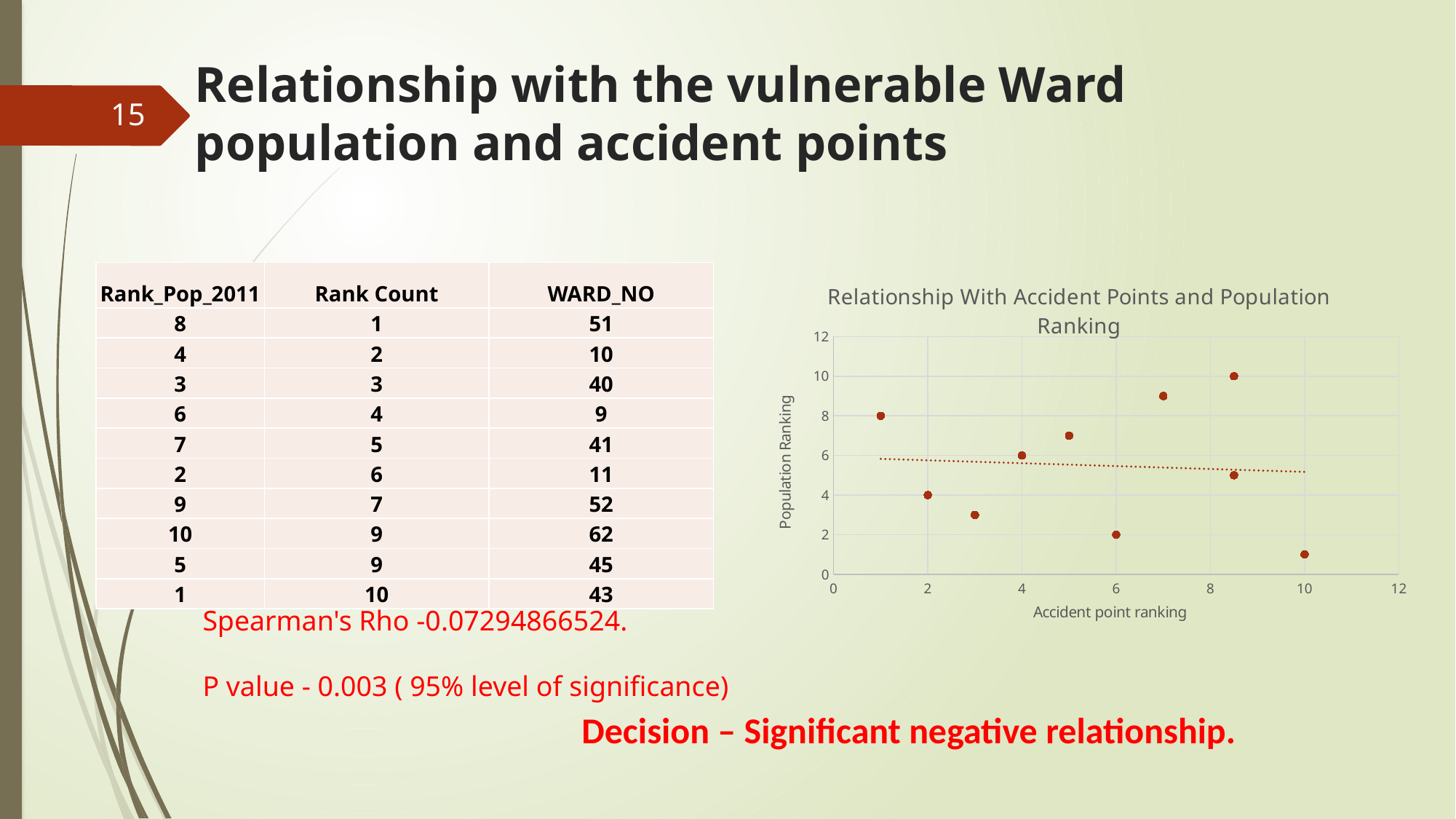
What is the label of the y axis of the chart? Population Ranking In the chart, is the population ranking of the point at accident point ranking 10 greater or less than 2? less How many data points are plotted in the scatter chart? 10 In the chart, what is the population ranking of the point at accident point ranking 6? 2 In the chart, what is the population ranking of the point at accident point ranking 2? 4 What is the title of the chart? Relationship With Accident Points and Population Ranking In the chart, which has the higher population ranking: the point at accident point ranking 6 or the point at accident point ranking 4? the point at accident point ranking 4 What kind of chart is shown on the slide? scatter chart Does the dotted trend line in the chart rise or fall as accident point ranking increases? fall In the chart, is the population ranking of the leftmost point greater or less than 6? greater In the chart, what is the population ranking of the point at accident point ranking 4? 6 In the chart, what is the highest population ranking value reached by any point? 10